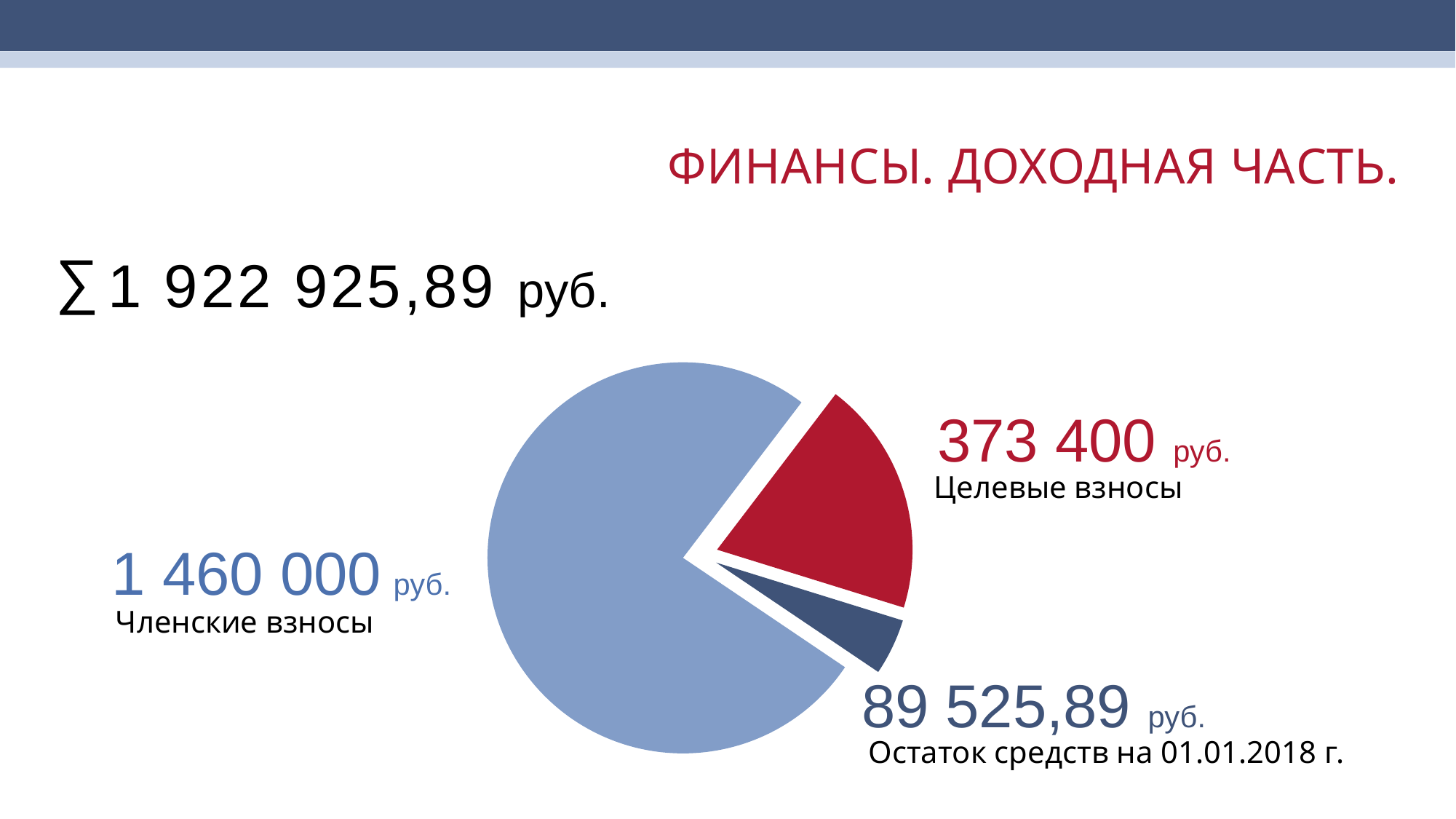
What is the value for Остаток средств на 01.01.2018 г.? 89 525,89 руб. How many slices does the pie chart have? 3 What is the difference between Целевые взносы and Остаток средств на 01.01.2018 г.? 283 874,11 руб. What is the difference between Членские взносы and Целевые взносы? 1 086 600 руб. Which category has the smallest slice of the pie? Остаток средств на 01.01.2018 г. Which category has the largest slice of the pie? Членские взносы What is the title of the slide containing the pie chart? ФИНАНСЫ. ДОХОДНАЯ ЧАСТЬ. What is the value for Целевые взносы? 373 400 руб. What total sum is shown on the slide for all slices of the pie? 1 922 925,89 руб. What is the value for Членские взносы? 1 460 000 руб. Which is larger, Целевые взносы or Остаток средств на 01.01.2018 г.? Целевые взносы What type of chart is shown on the slide? Pie chart